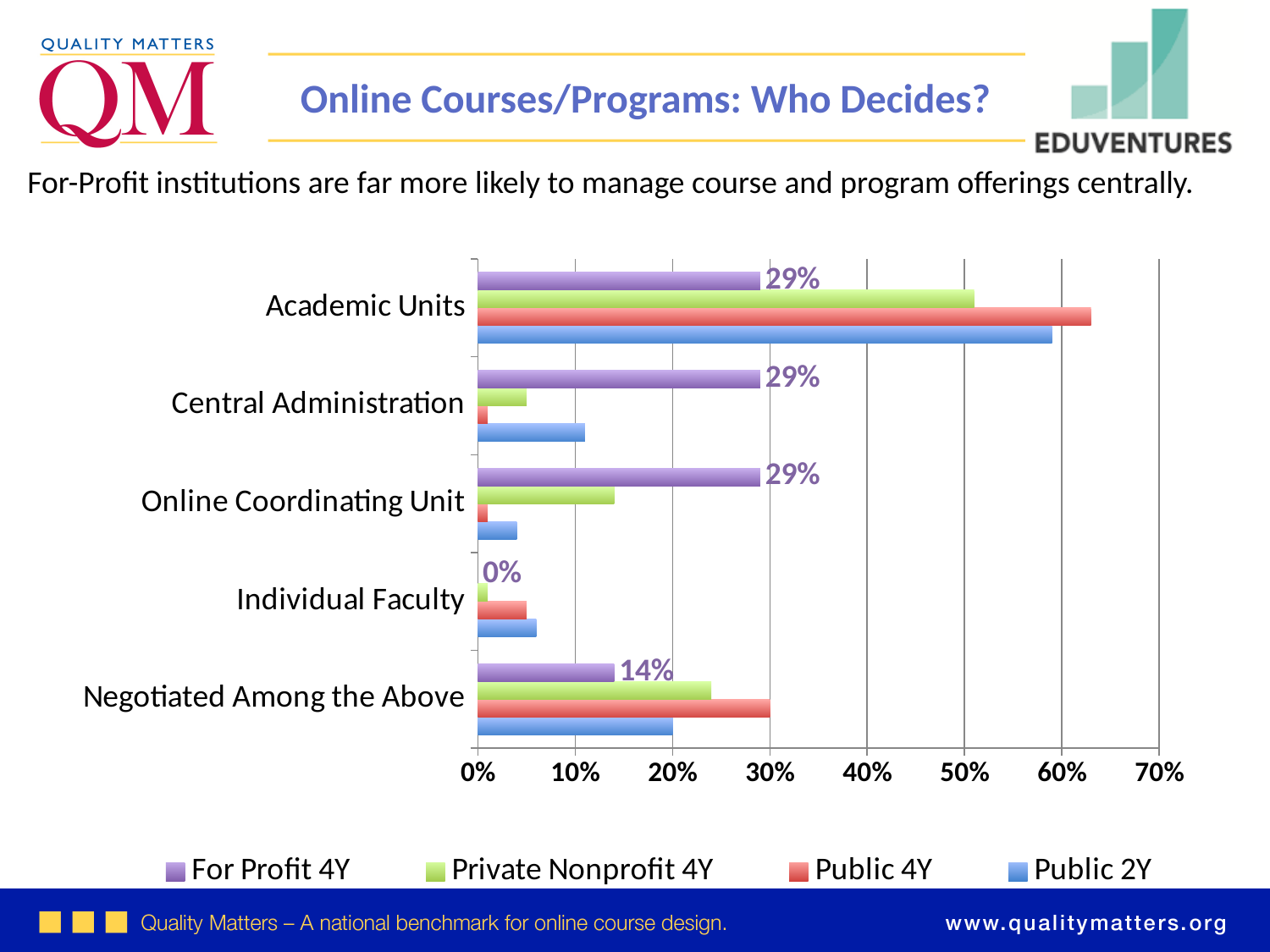
What is the title of the chart on the slide? Online Courses/Programs: Who Decides? Which category has the lowest value for the For Profit 4Y series? Individual Faculty Is the value for Public 2Y in the Central Administration category greater or less than 20%? less Is the value for Public 4Y in the Academic Units category greater or less than 60%? greater In the Academic Units category, which series has the highest value? Public 4Y What is the difference between the For Profit 4Y values for Academic Units and Negotiated Among the Above? 15 percentage points What kind of chart is shown on the slide? Bar chart What is the value for For Profit 4Y in the Negotiated Among the Above category? 14% How many series does the legend list? 4 How many categories are shown on the chart? 5 What is the value for For Profit 4Y in the Academic Units category? 29% What is the value for For Profit 4Y in the Individual Faculty category? 0%